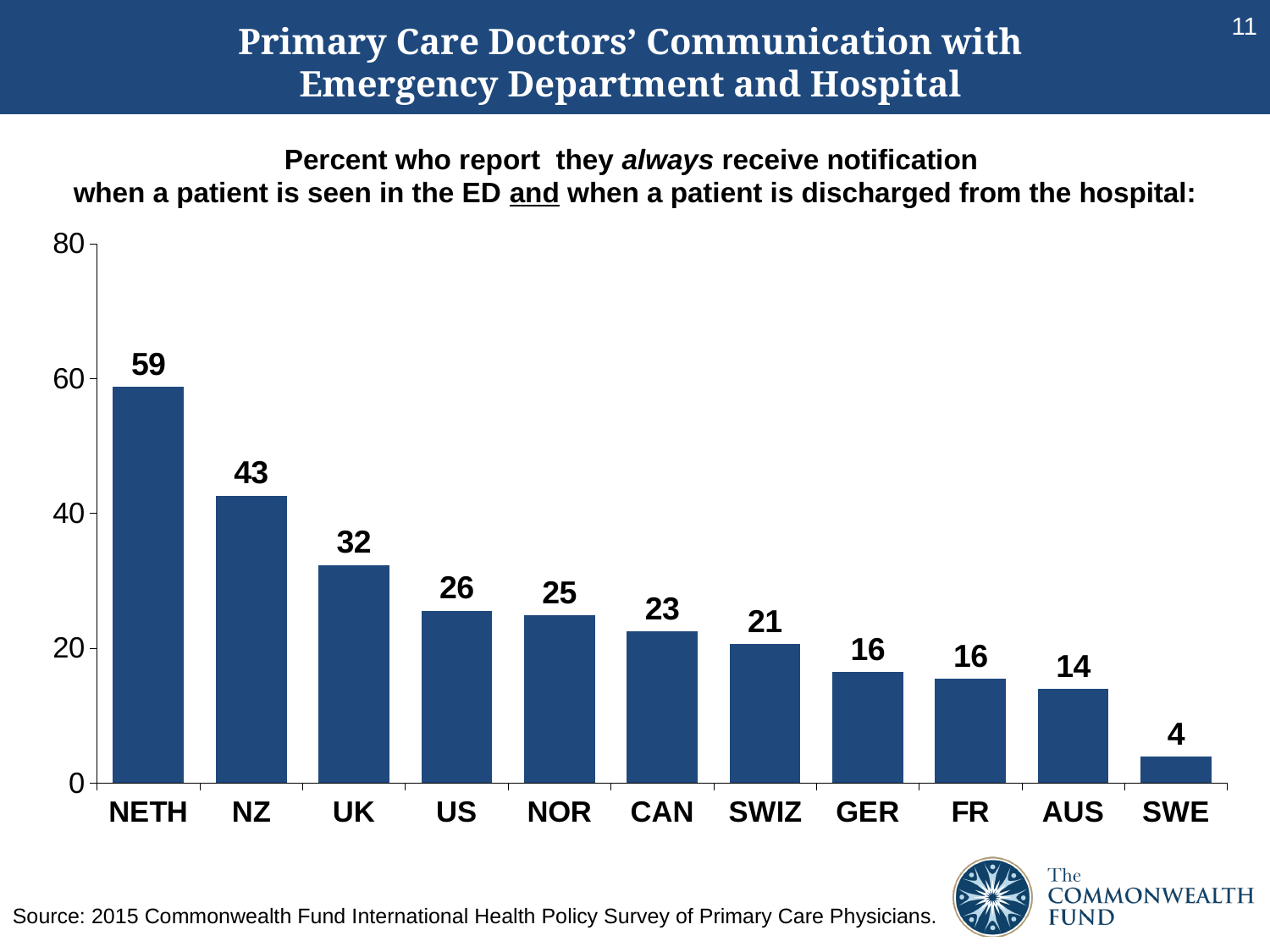
Is the value for NZ greater or less than 40? greater What is the value for CAN? 23 What is the value for NETH? 59 Do the values rise or fall from left to right across the countries? fall How many countries are shown on the chart? 11 Which is larger, the value for US or the value for SWIZ? US What is the difference between the values for UK and AUS? 18 Which country has the highest value? NETH What is the value for SWE? 4 Which country has the lowest value? SWE What is the difference between the values for NETH and NZ? 16 What kind of chart is shown on the slide? bar chart